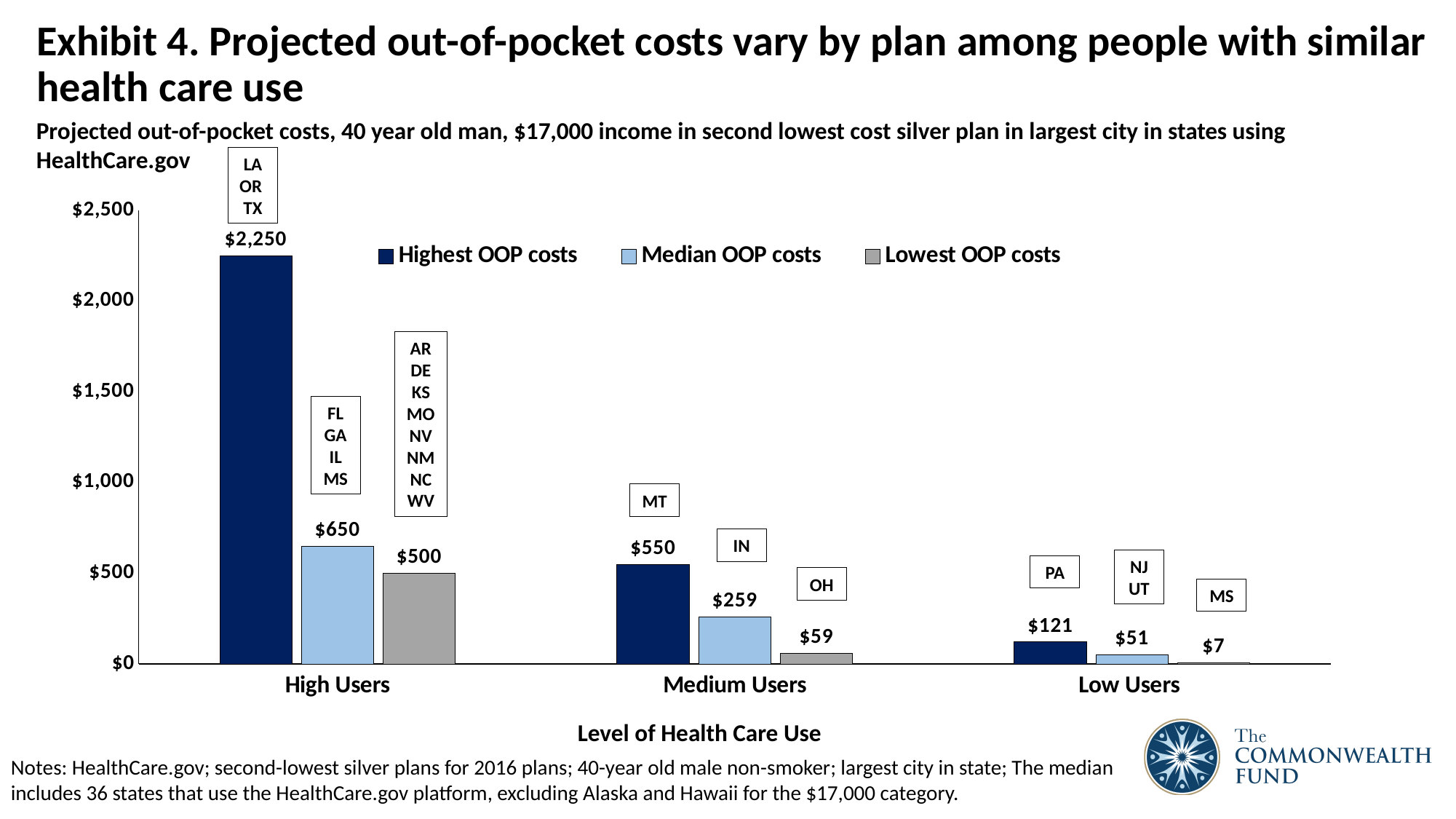
What is the Median OOP costs value for Medium Users? $259 Which is larger: the Median OOP costs value for High Users or the Highest OOP costs value for Medium Users? Median OOP costs for High Users Which states are labelled above the Lowest OOP costs bar for Low Users? MS How many series does the legend list? 3 Which level of health care use has the highest Highest OOP costs value? High Users What kind of chart is shown on the slide? bar chart What is the Highest OOP costs value for High Users? $2,250 How many levels of health care use are shown on the x axis? 3 What is the difference between the Highest OOP costs and Lowest OOP costs values for Medium Users? $491 Which level of health care use has the lowest Median OOP costs value? Low Users What is the Lowest OOP costs value for Low Users? $7 Is the Highest OOP costs value for High Users greater or less than $2,000? greater